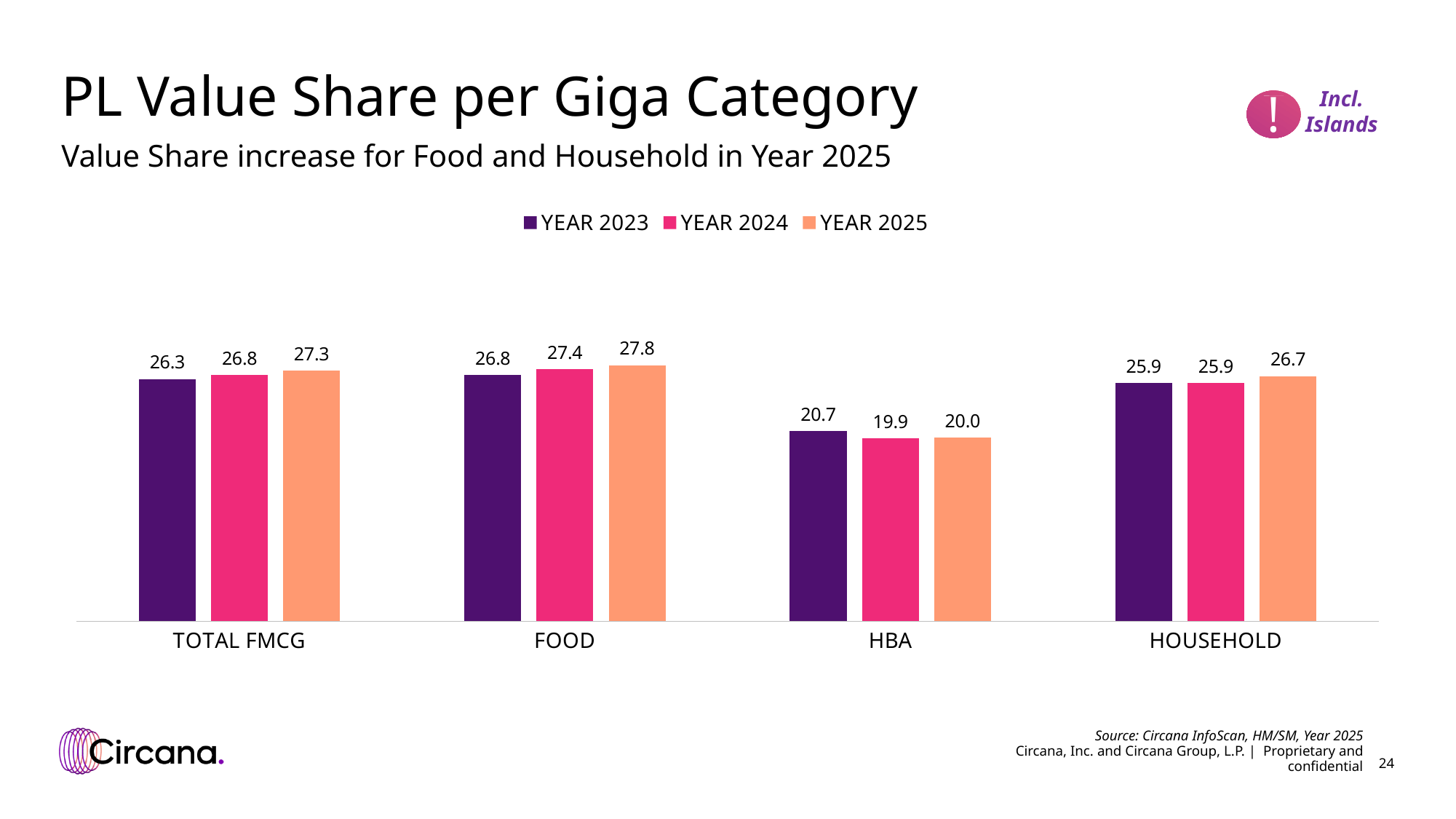
Which is larger for HBA: the YEAR 2023 value or the YEAR 2025 value? YEAR 2023 Do the values for FOOD rise or fall from YEAR 2023 to YEAR 2025? Rise What is the PL value share for FOOD in YEAR 2025? 27.8 What is the difference between the YEAR 2025 and YEAR 2023 values for TOTAL FMCG? 1.0 What is the PL value share for TOTAL FMCG in YEAR 2023? 26.3 Which category has the highest PL value share in YEAR 2025? FOOD What kind of chart is shown on the slide? Bar chart What is the PL value share for HBA in YEAR 2023? 20.7 Which category has the lowest PL value share in YEAR 2024? HBA How many series does the legend list? 3 How many categories are shown on the x axis? 4 What is the PL value share for HOUSEHOLD in YEAR 2024? 25.9